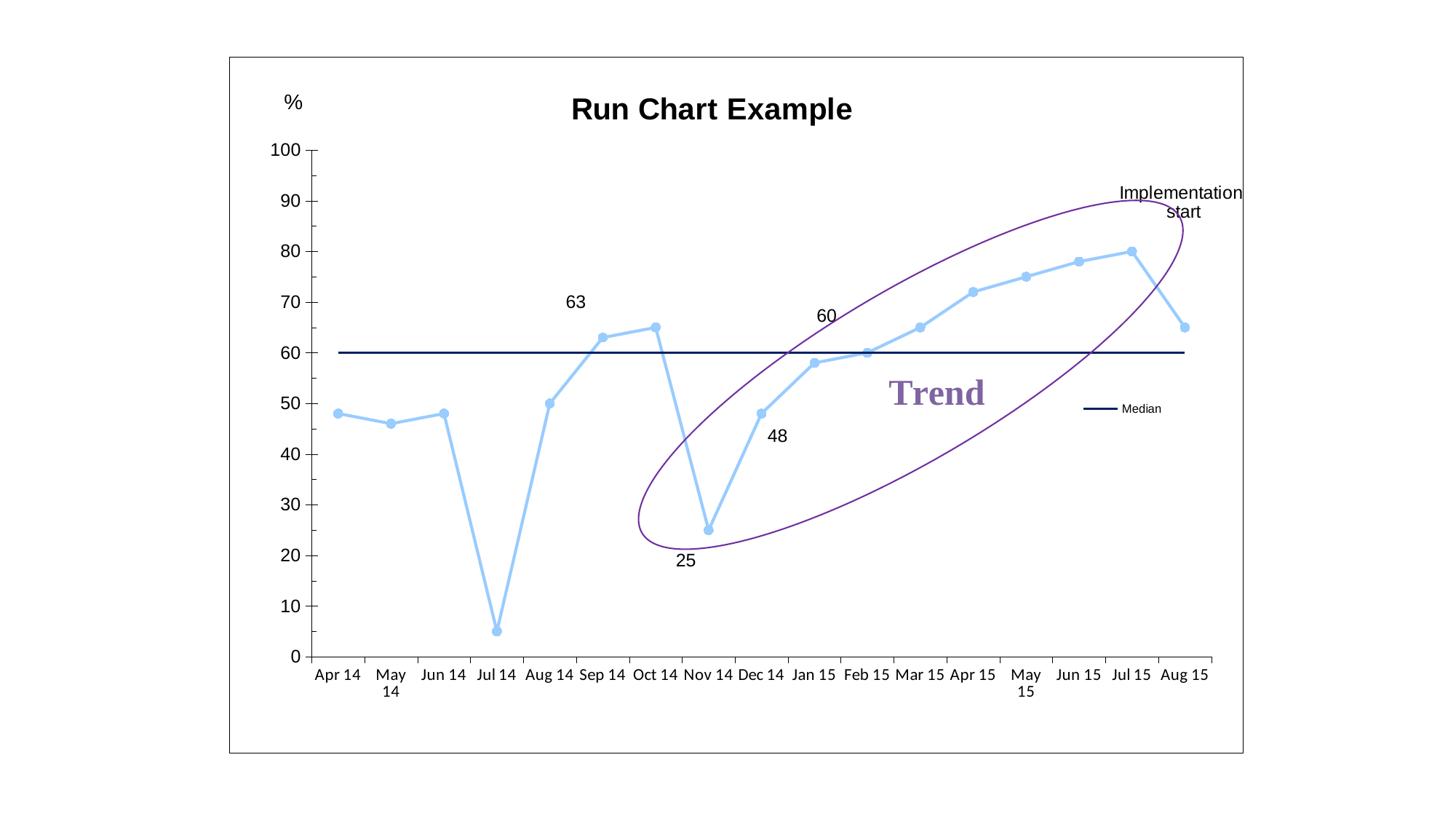
Which month has the lowest value? Jul 14 What is the value for Sep 14? 63 What is the title of the chart? Run Chart Example Is the value for Apr 15 greater or less than 70? greater What is the value for Dec 14? 48 What is the value for Nov 14? 25 What is the value for Feb 15? 60 Which is larger, the value for Oct 14 or the value for Nov 14? Oct 14 Do the values rise or fall from Nov 14 to Jul 15? rise What type of chart is shown on the slide? line chart What is the difference between the values for Sep 14 and Nov 14? 38 How many data points are plotted on the line from Apr 14 to Aug 15? 17